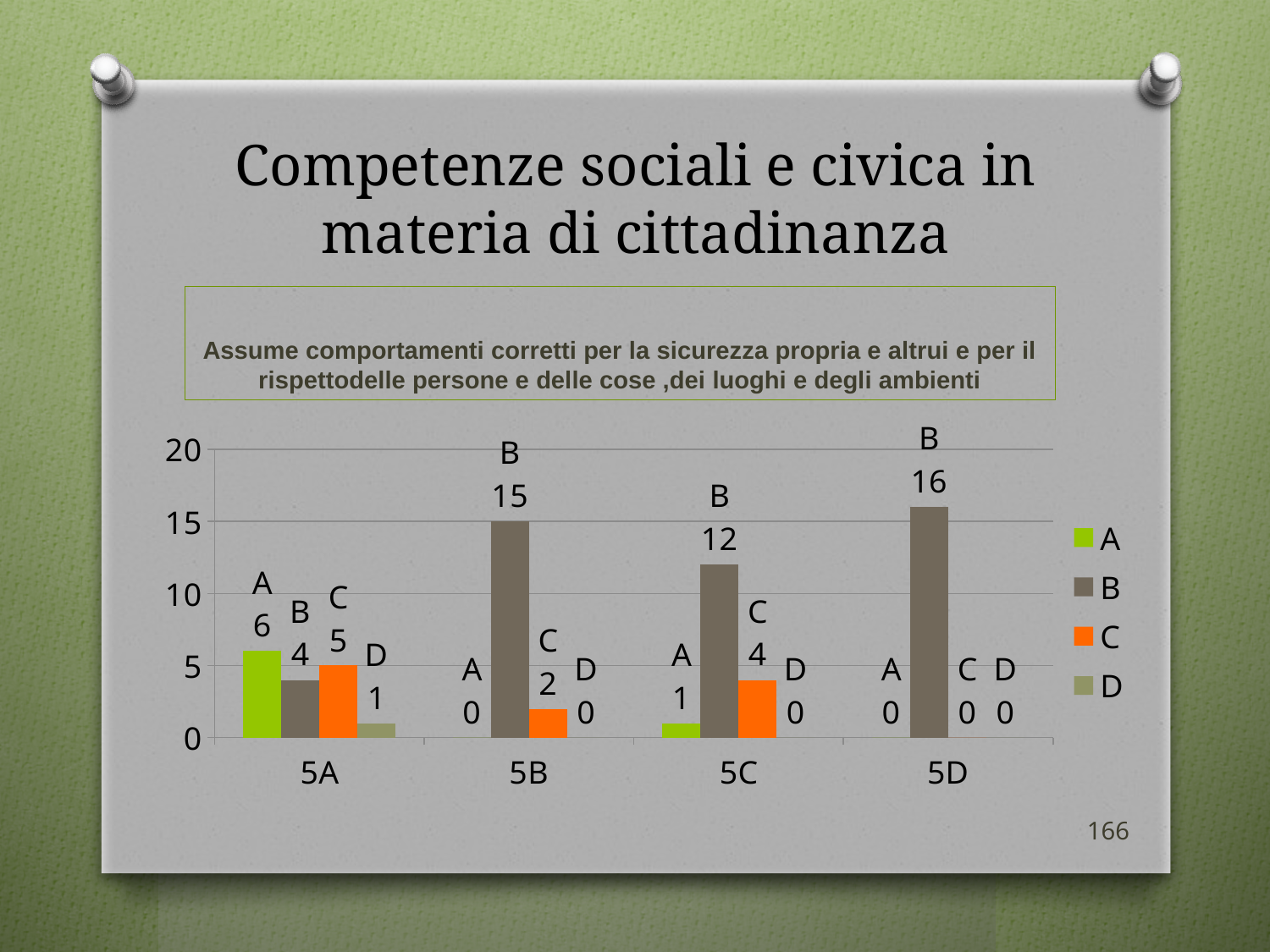
Which is larger: the C value for 5A or the C value for 5C? 5A Which category has the lowest value for series B? 5A What is the total of the four series values for category 5A? 16 How many series does the legend list? 4 Which category has the highest value for series B? 5D What is the value for series C in category 5B? 2 How many categories are shown on the x axis? 4 What is the value for series A in category 5A? 6 What kind of chart is shown on the slide? bar chart Is the value for B in 5D greater or less than 15? greater What is the difference between the B values for 5B and 5C? 3 What is the value for series B in category 5D? 16